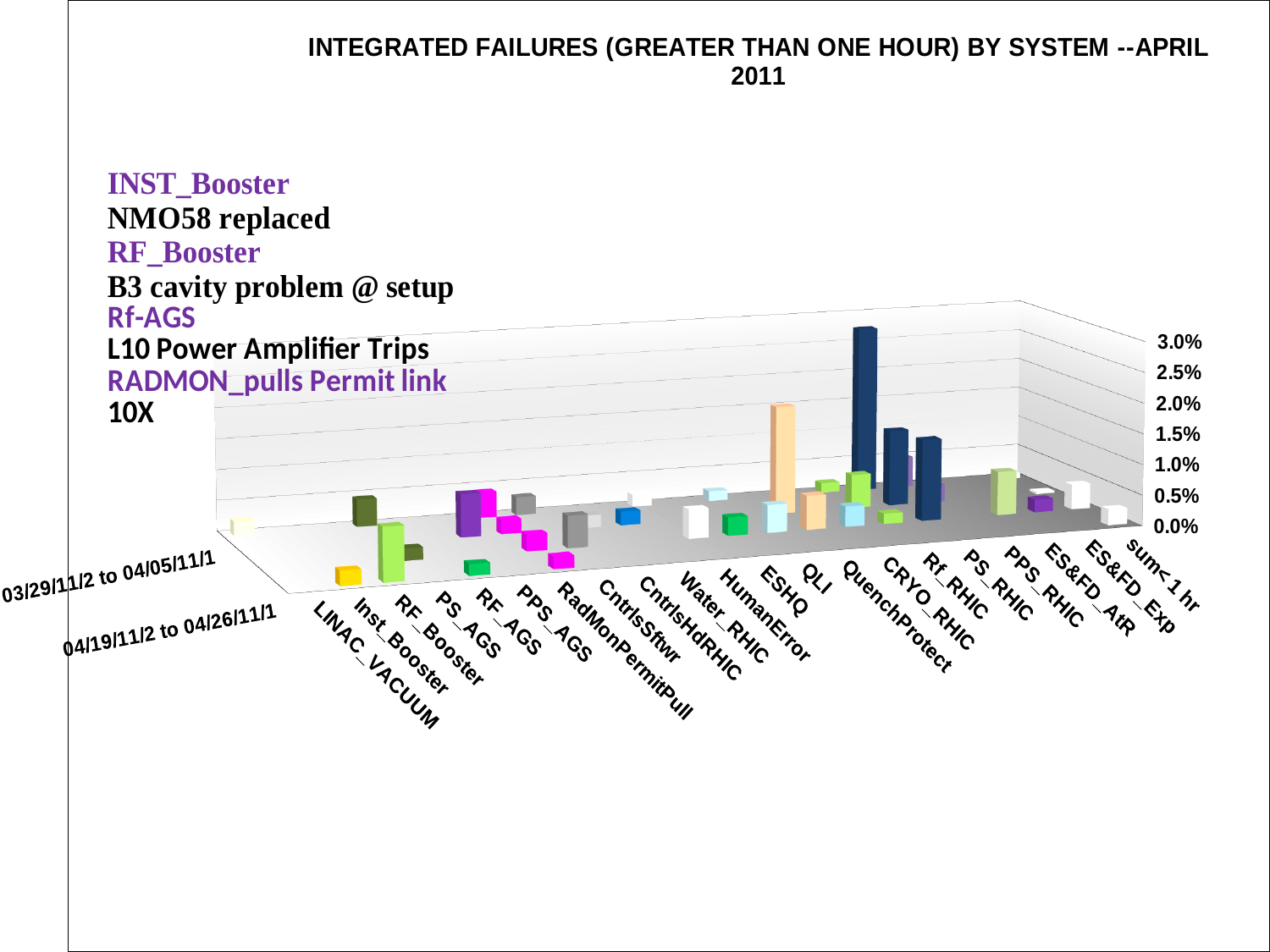
What is the title of the chart? INTEGRATED FAILURES (GREATER THAN ONE HOUR) BY SYSTEM --APRIL 2011 What is the lowest tick label on the vertical axis of the chart? 0.0% What date range is labelled on the back row of the depth axis? 03/29/11/2 to 04/05/11/1 What is the first category on the x axis of the chart? LINAC_VACUUM What is the highest value shown on the vertical axis of the chart? 3.0% What is the interval between tick marks on the vertical axis of the chart? 0.5% What kind of chart is shown on the slide? 3D bar chart How many system categories are listed along the x axis of the chart? 21 What date range is labelled on the front row of the depth axis? 04/19/11/2 to 04/26/11/1 What is the last category on the x axis of the chart? sum< 1 hr